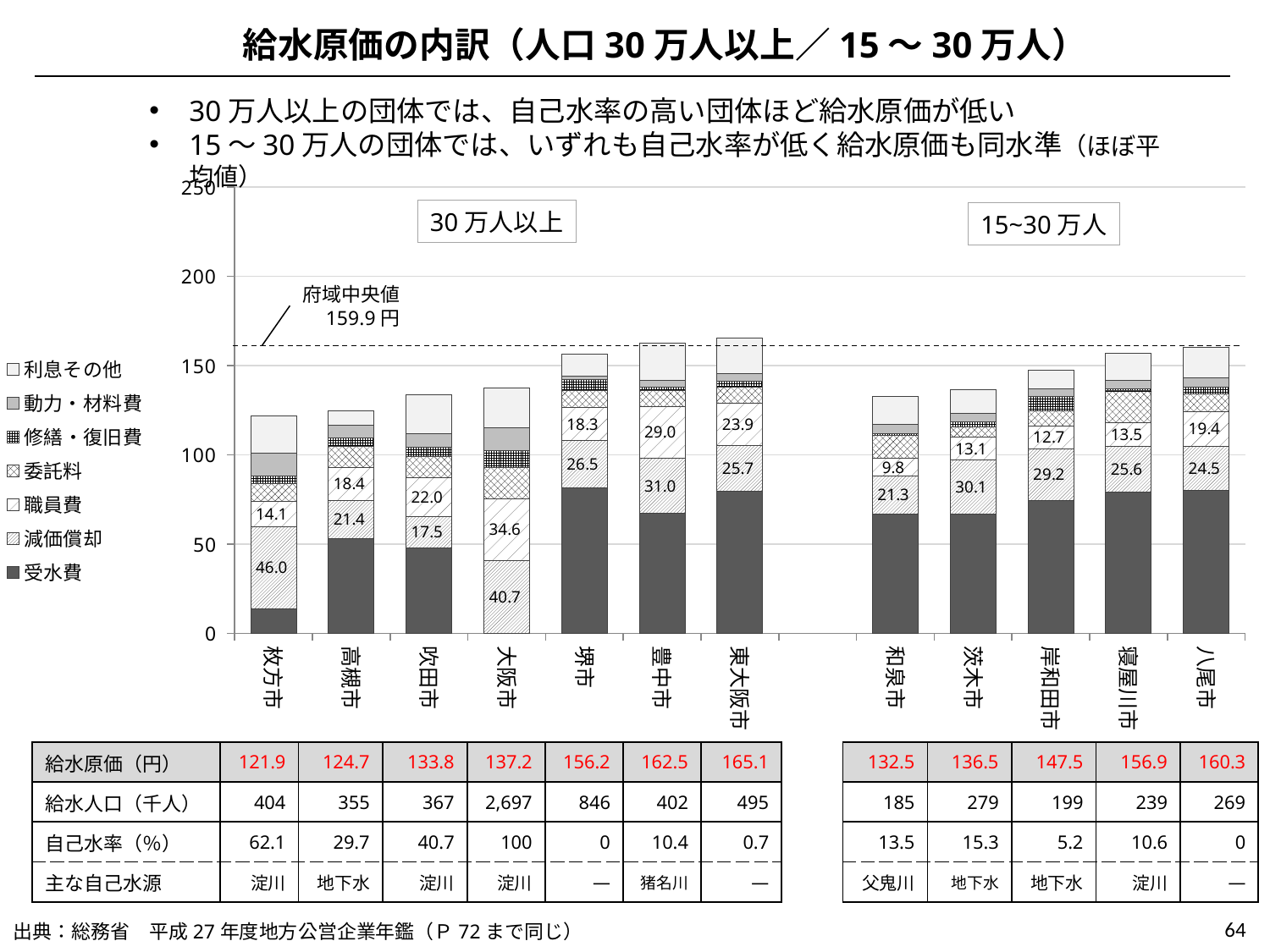
Which is larger, the 減価償却 label for 堺市 or for 豊中市? 豊中市 What is the 減価償却 value labelled on the bar for 茨木市? 30.1 What value is given for the 府域中央値 dashed line on the chart? 159.9円 How many series does the chart legend list? 7 What is the 減価償却 value labelled on the bar for 枚方市? 46.0 Which municipality has the lowest 職員費 label on its bar? 和泉市 How many municipalities (categories) are plotted on the x axis? 12 What type of chart is shown on the slide? stacked bar chart What is the difference between the 職員費 labels for 豊中市 (29.0) and 岸和田市 (12.7)? 16.3 What is the 職員費 value labelled on the bar for 大阪市? 34.6 Which municipality has the highest 減価償却 label on its bar? 枚方市 Is the total bar height for 東大阪市 greater or less than 150? greater